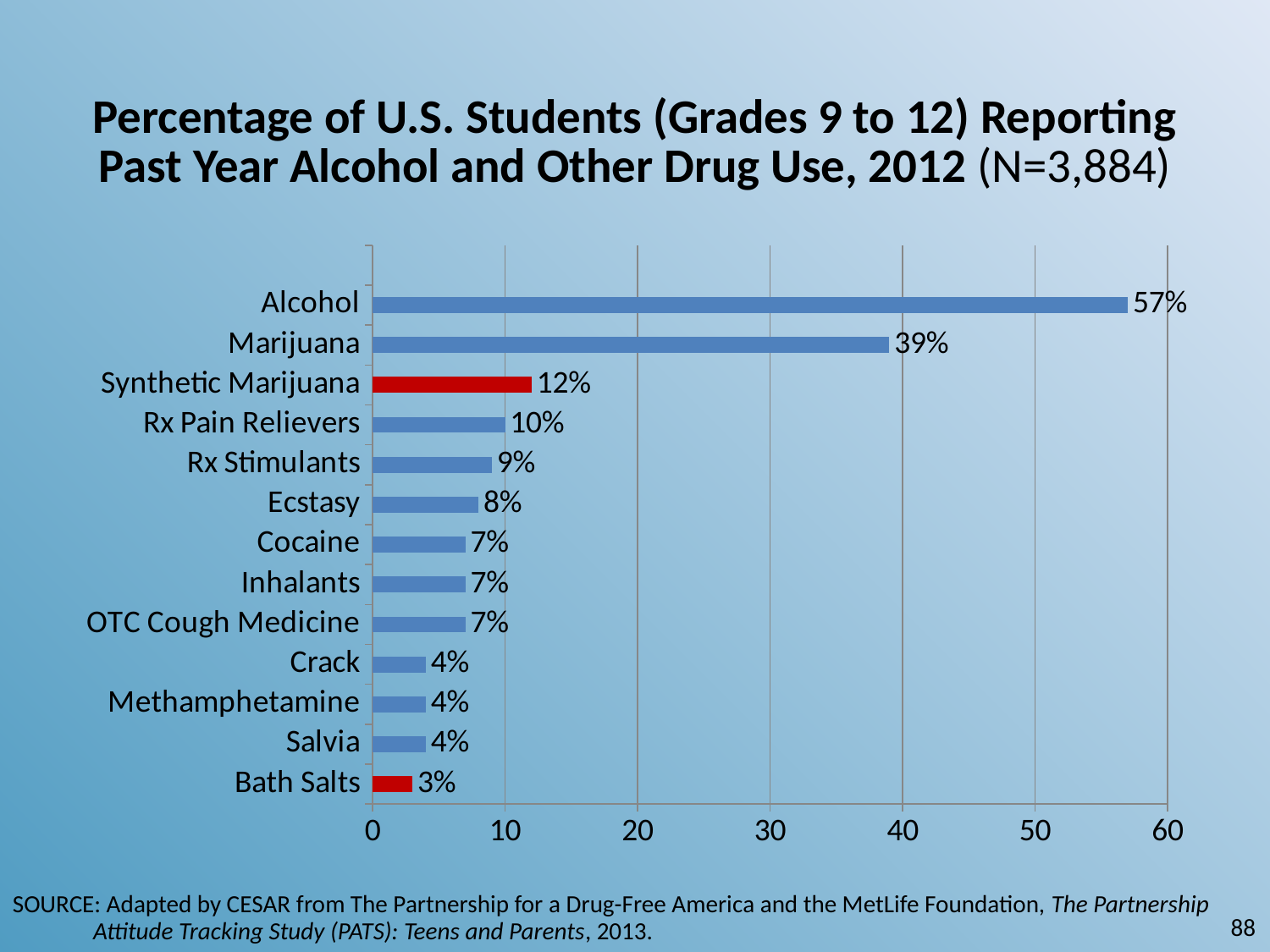
What is the value shown for Synthetic Marijuana? 12% What percentage is shown for Rx Stimulants? 9% What is the difference between the values for Alcohol and Marijuana? 18% Which is larger, the value for Rx Pain Relievers or the value for Ecstasy? Rx Pain Relievers Which two bars are coloured red instead of blue? Synthetic Marijuana and Bath Salts Is the value for Marijuana greater or less than 40? less What percentage of students reported past year alcohol use? 57% Which category has the lowest value? Bath Salts What is the difference between the values for Synthetic Marijuana and Bath Salts? 9% What kind of chart is shown on the slide? bar chart How many categories are shown in the chart? 13 Which category has the highest value? Alcohol